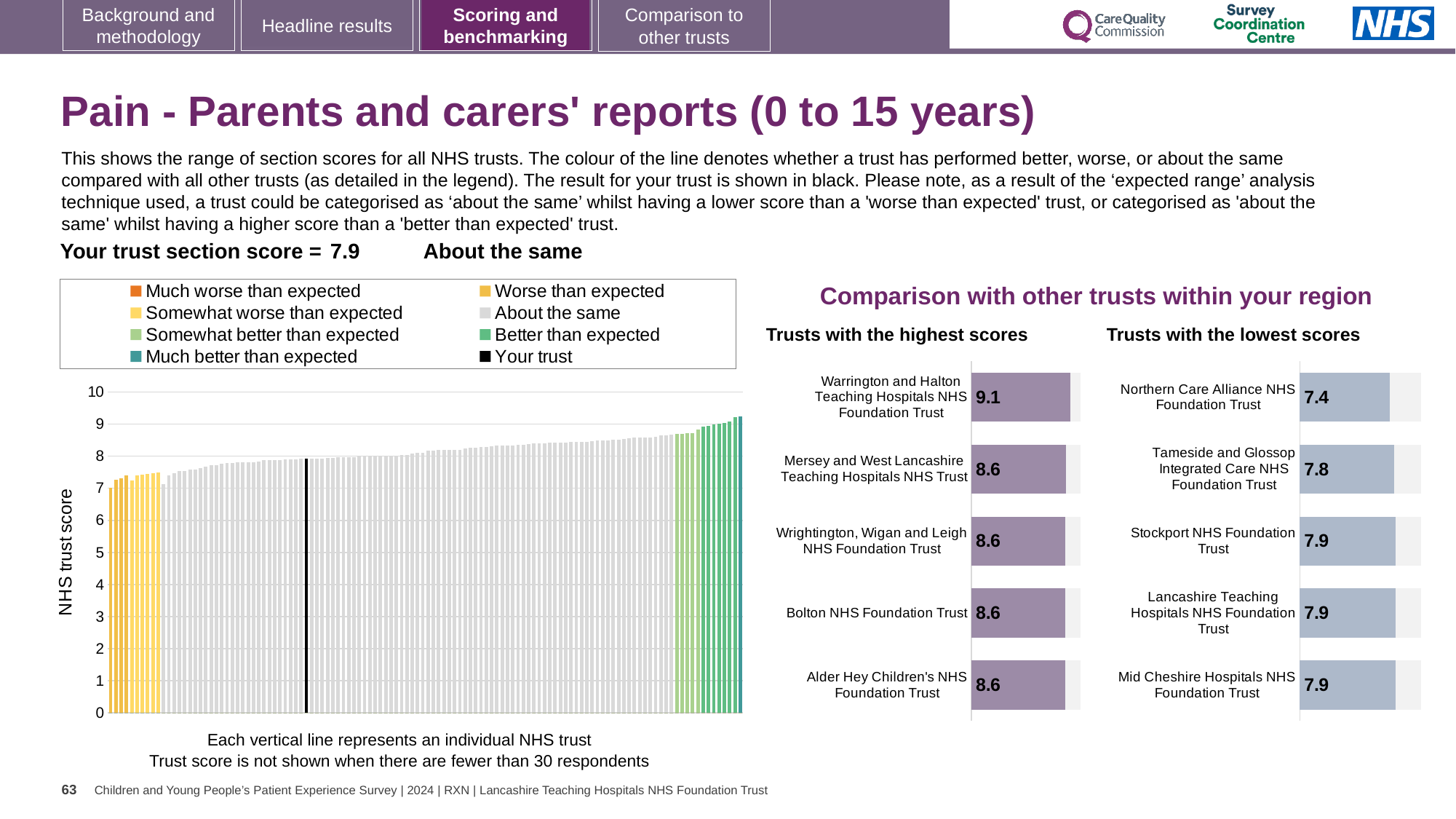
In the 'Trusts with the lowest scores' chart, what is the difference between the scores of Stockport NHS Foundation Trust and Northern Care Alliance NHS Foundation Trust? 0.5 In the 'Trusts with the highest scores' chart, what is the difference between the scores of Warrington and Halton Teaching Hospitals NHS Foundation Trust and Bolton NHS Foundation Trust? 0.5 In the 'Trusts with the lowest scores' chart, what is the score for Tameside and Glossop Integrated Care NHS Foundation Trust? 7.8 How many entries does the legend of the large chart on the left list? 8 In the 'Trusts with the lowest scores' chart, what is the score for Northern Care Alliance NHS Foundation Trust? 7.4 In the large chart on the left showing all NHS trusts, do the bar values rise or fall from left to right? rise In the 'Trusts with the highest scores' chart, what is the score for Warrington and Halton Teaching Hospitals NHS Foundation Trust? 9.1 In the 'Trusts with the highest scores' chart, which trust has the highest score? Warrington and Halton Teaching Hospitals NHS Foundation Trust How many trusts are listed in the 'Trusts with the highest scores' chart? 5 In the 'Trusts with the lowest scores' chart, which trust has the lowest score? Northern Care Alliance NHS Foundation Trust In the 'Trusts with the lowest scores' chart, which has the larger score: Tameside and Glossop Integrated Care NHS Foundation Trust or Northern Care Alliance NHS Foundation Trust? Tameside and Glossop Integrated Care NHS Foundation Trust In the large chart on the left showing all NHS trusts, is the value of the leftmost bar greater or less than 6? greater